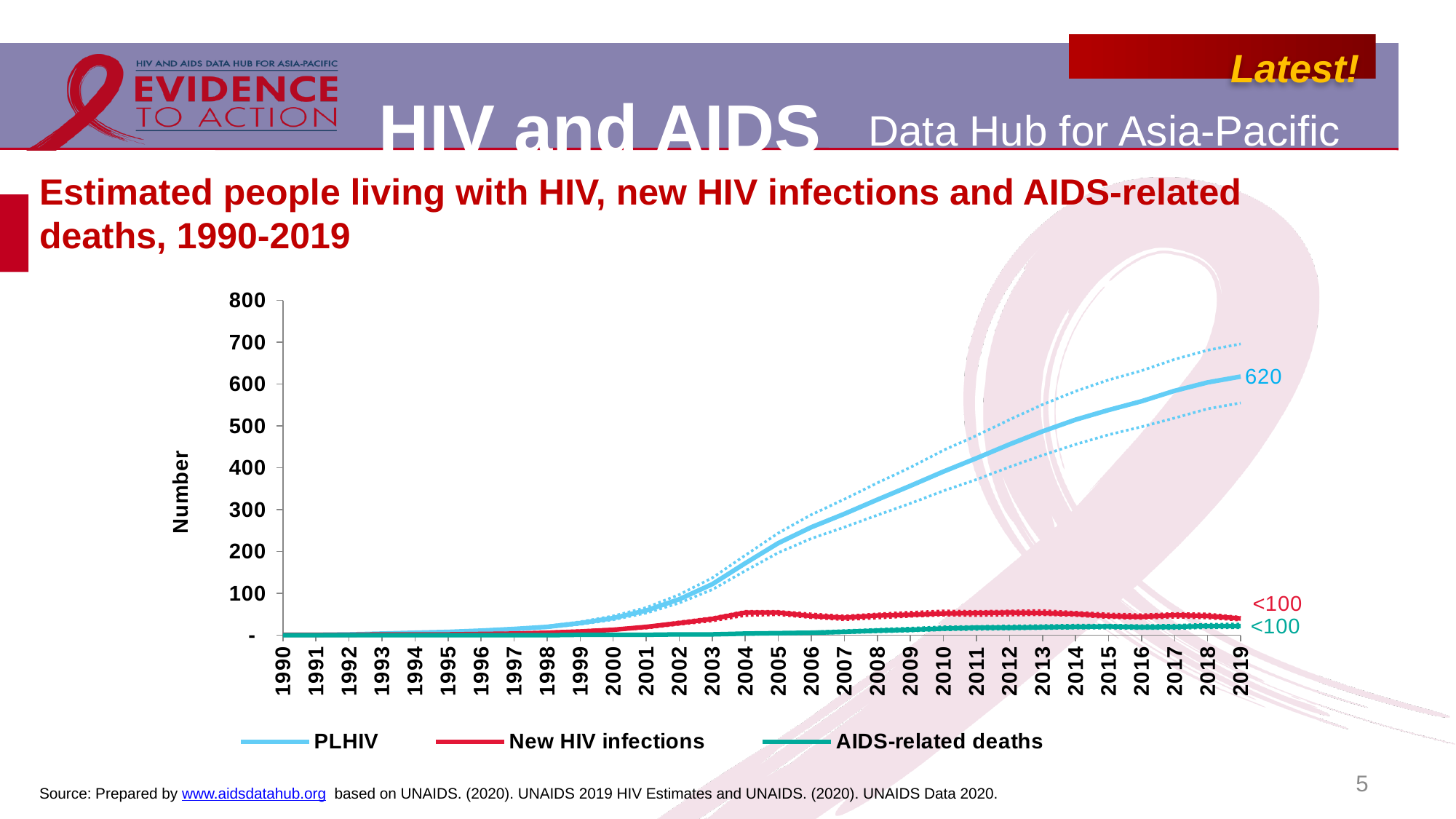
Which series has the highest value in 2019? PLHIV Is the value for PLHIV in 2010 greater or less than 300? greater What type of chart is shown on the slide? line chart What is the label of the y axis? Number Does the PLHIV line rise or fall from 1990 to 2019? rise What is the labelled value for New HIV infections in 2019? <100 Is the value for PLHIV in 2000 greater or less than 100? less How many series does the legend list? 3 What is the first year shown on the x axis? 1990 Which is larger in 2019, PLHIV or New HIV infections? PLHIV What is the labelled value for PLHIV in 2019? 620 What is the labelled value for AIDS-related deaths in 2019? <100